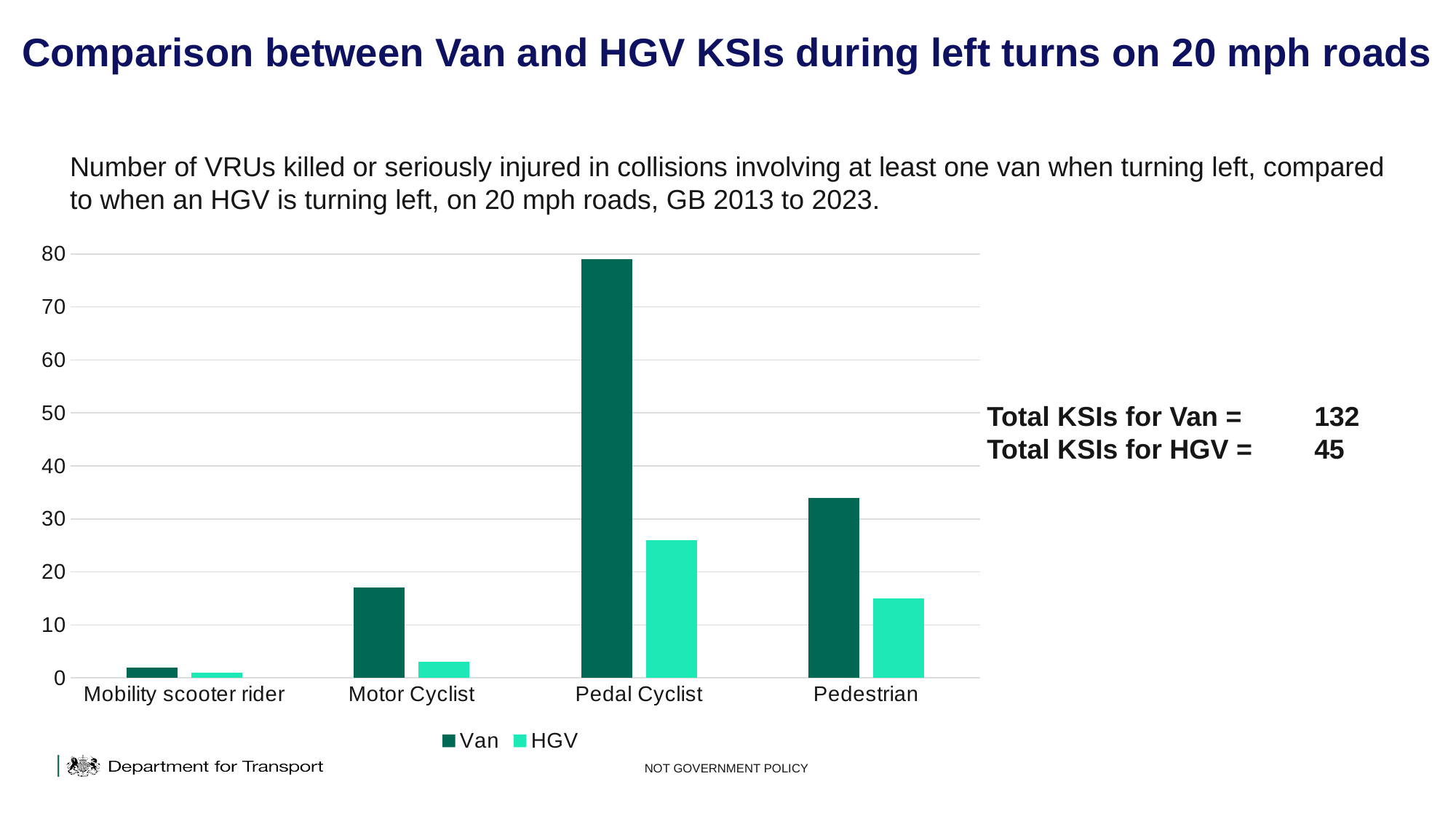
What kind of chart is shown on the slide? bar chart Which category has the lowest HGV value? Mobility scooter rider Which category has the highest Van value? Pedal Cyclist Which is larger for Pedestrian, the Van value or the HGV value? Van Is the HGV value for Pedal Cyclist greater or less than 30? less What is the difference between the total KSIs for Van and the total KSIs for HGV stated on the slide? 87 Is the Van value for Motor Cyclist greater or less than 20? less How many categories are shown on the x axis? 4 What is the total KSIs for Van stated on the slide? 132 What are the two series named in the legend? Van and HGV How many series does the legend list? 2 Is the Van value for Pedal Cyclist greater or less than 70? greater